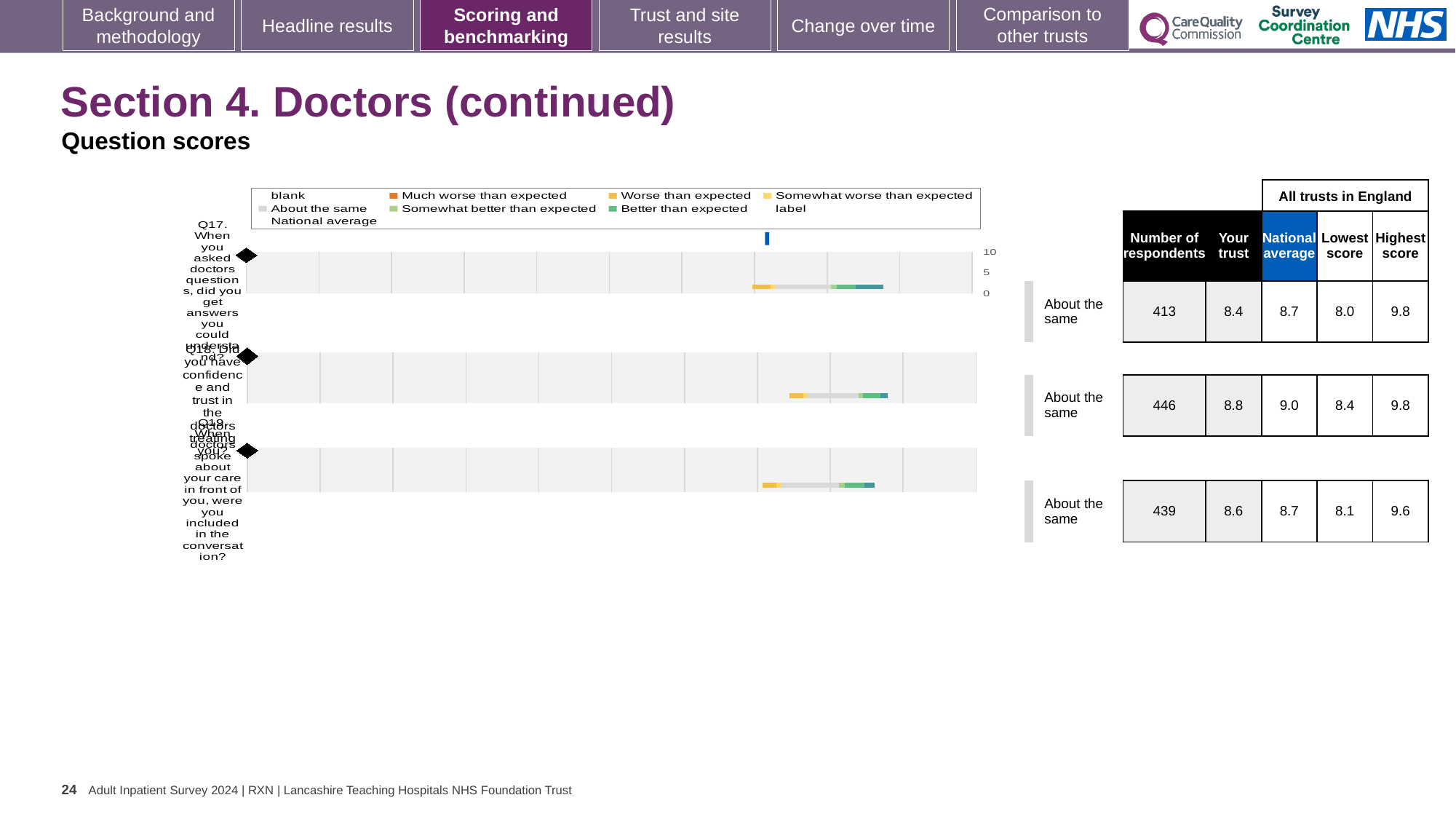
What is the highest score across all trusts in England for Q19? 9.6 How many respondents are shown for Q19? 439 What is the 'Your trust' score for Q17? 8.4 What is the difference between the national average and the 'Your trust' score for Q18? 0.2 What kind of chart is used to show the question scores on this slide? bar chart For Q17, which is larger: the 'Your trust' score or the national average? National average What colour does the legend use for 'Much worse than expected'? Orange Which question has the lowest 'Lowest score' value? Q17 How many questions (categories) are plotted in the chart? 3 What benchmark category is shown for Q17? About the same Which question has the highest 'Your trust' score? Q18 What is the national average score for Q18? 9.0